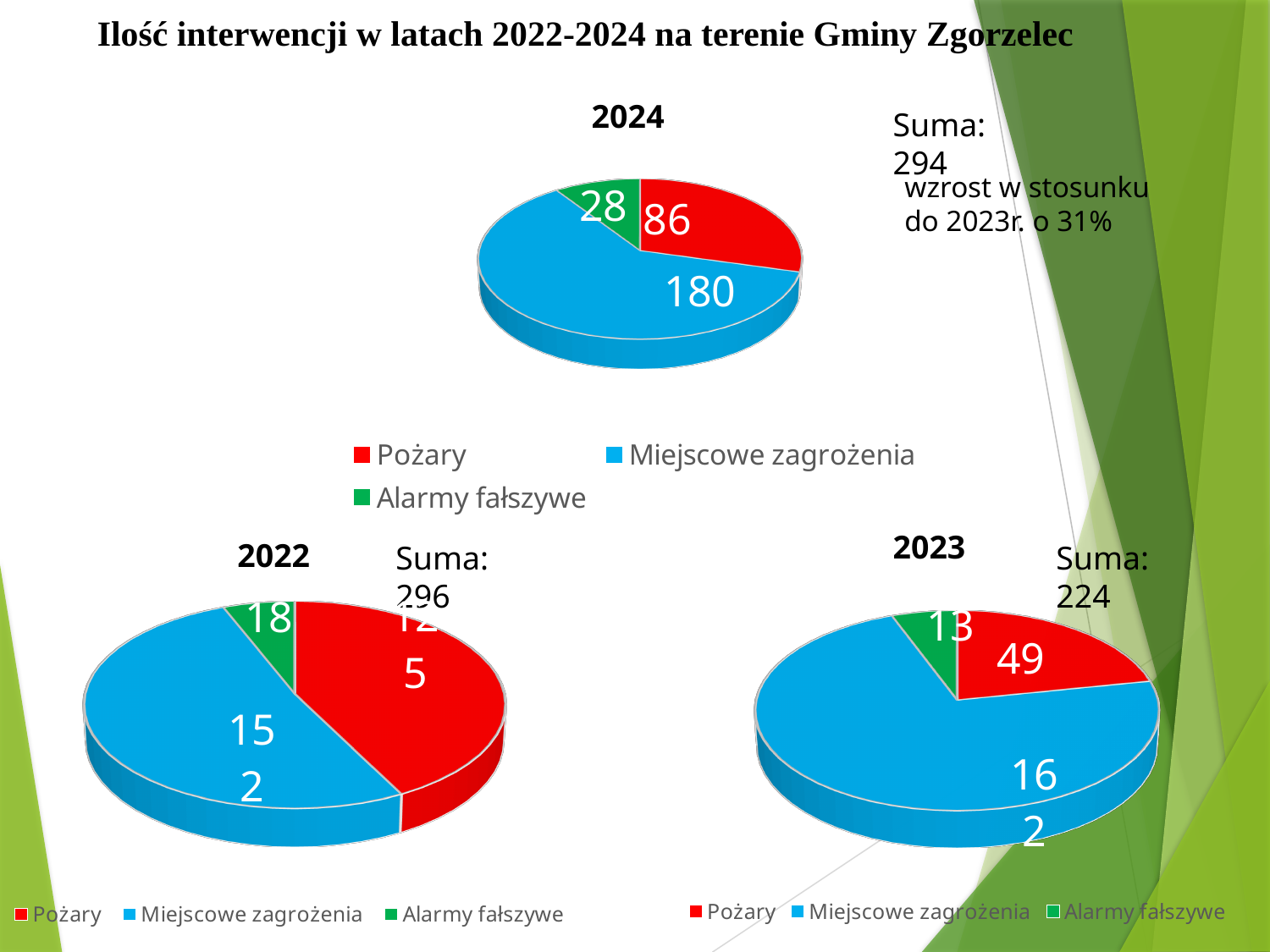
In the 2024 pie chart, what is the value for Alarmy fałszywe? 28 In the 2024 pie chart, what is the value for Pożary? 86 In the 2022 pie chart, which is larger: Pożary or Alarmy fałszywe? Pożary How many categories does the legend of the 2024 pie chart list? 3 In the 2022 pie chart, what is the value for Alarmy fałszywe? 18 What type of chart is used for the 2023 data? Pie chart In the 2023 pie chart, what is the value for Pożary? 49 In the 2023 pie chart, what is the value for Alarmy fałszywe? 13 In the 2024 pie chart, what is the difference between Miejscowe zagrożenia and Pożary? 94 In the 2024 pie chart, what is the value for Miejscowe zagrożenia? 180 In the 2023 pie chart, which category has the smallest slice? Alarmy fałszywe In the 2024 pie chart, which category has the largest slice? Miejscowe zagrożenia